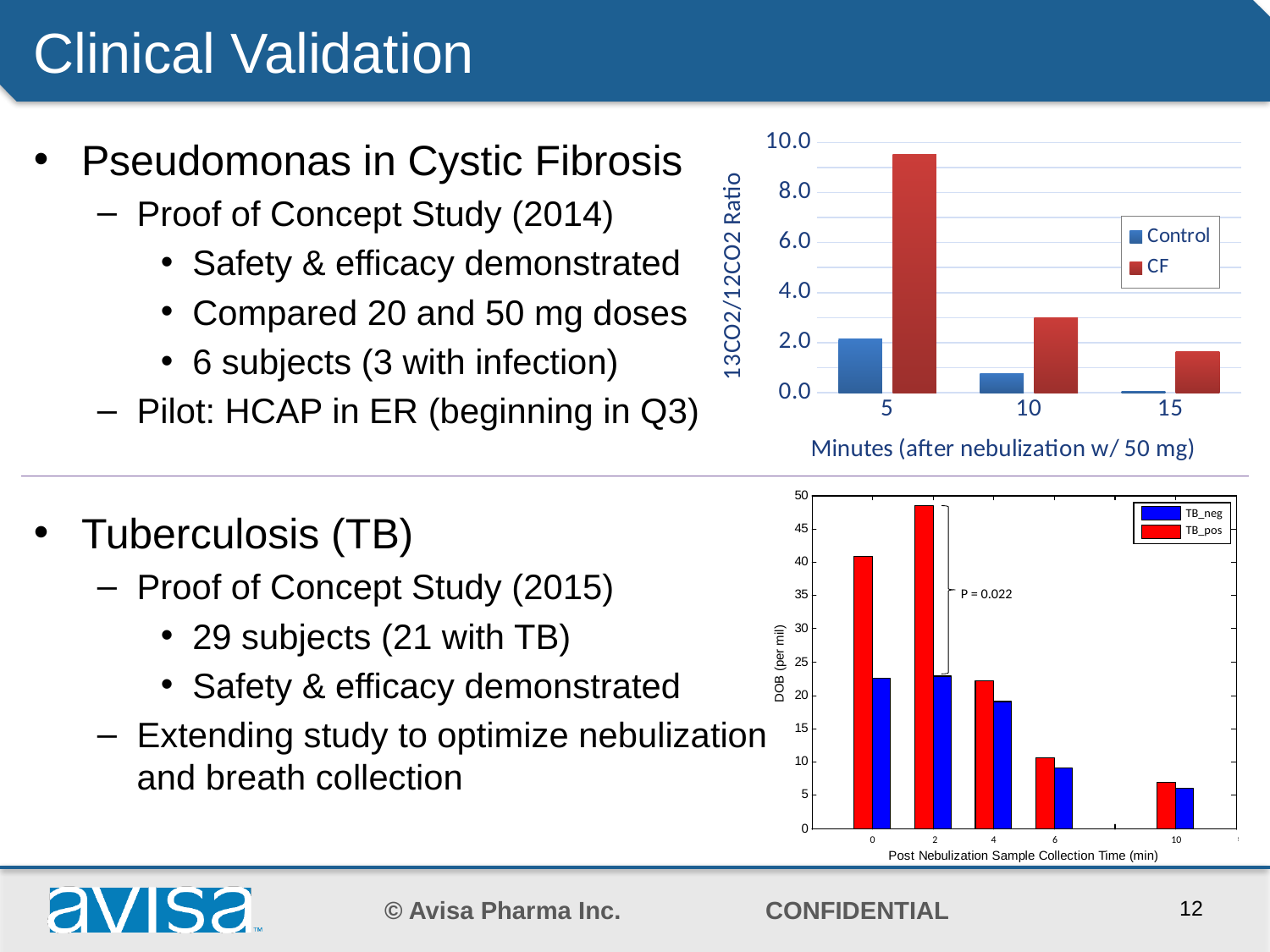
In the top-right chart (13CO2/12CO2 Ratio), which series has the highest bar at 5 minutes? CF In the top-right chart (13CO2/12CO2 Ratio), how many series does the legend list? 2 In the top-right chart (13CO2/12CO2 Ratio), do the CF values rise or fall as minutes increase? fall What kind of chart is the top-right chart (13CO2/12CO2 Ratio)? bar chart In the top-right chart (13CO2/12CO2 Ratio), is the Control value at 10 minutes greater or less than 2.0? less In the bottom-right chart (DOB per mil), how many time-point categories are shown on the x axis? 5 In the top-right chart (13CO2/12CO2 Ratio), at which time point is the CF value highest? 5 In the bottom-right chart (DOB per mil), is the TB_pos value at 2 minutes greater or less than 45? greater In the top-right chart (13CO2/12CO2 Ratio), is the CF value at 5 minutes greater or less than 8.0? greater What is the x-axis title of the top-right chart? Minutes (after nebulization w/ 50 mg) In the bottom-right chart (DOB per mil), which series is shown in red according to the legend? TB_pos In the bottom-right chart (DOB per mil), at which collection time is the TB_pos value highest? 2